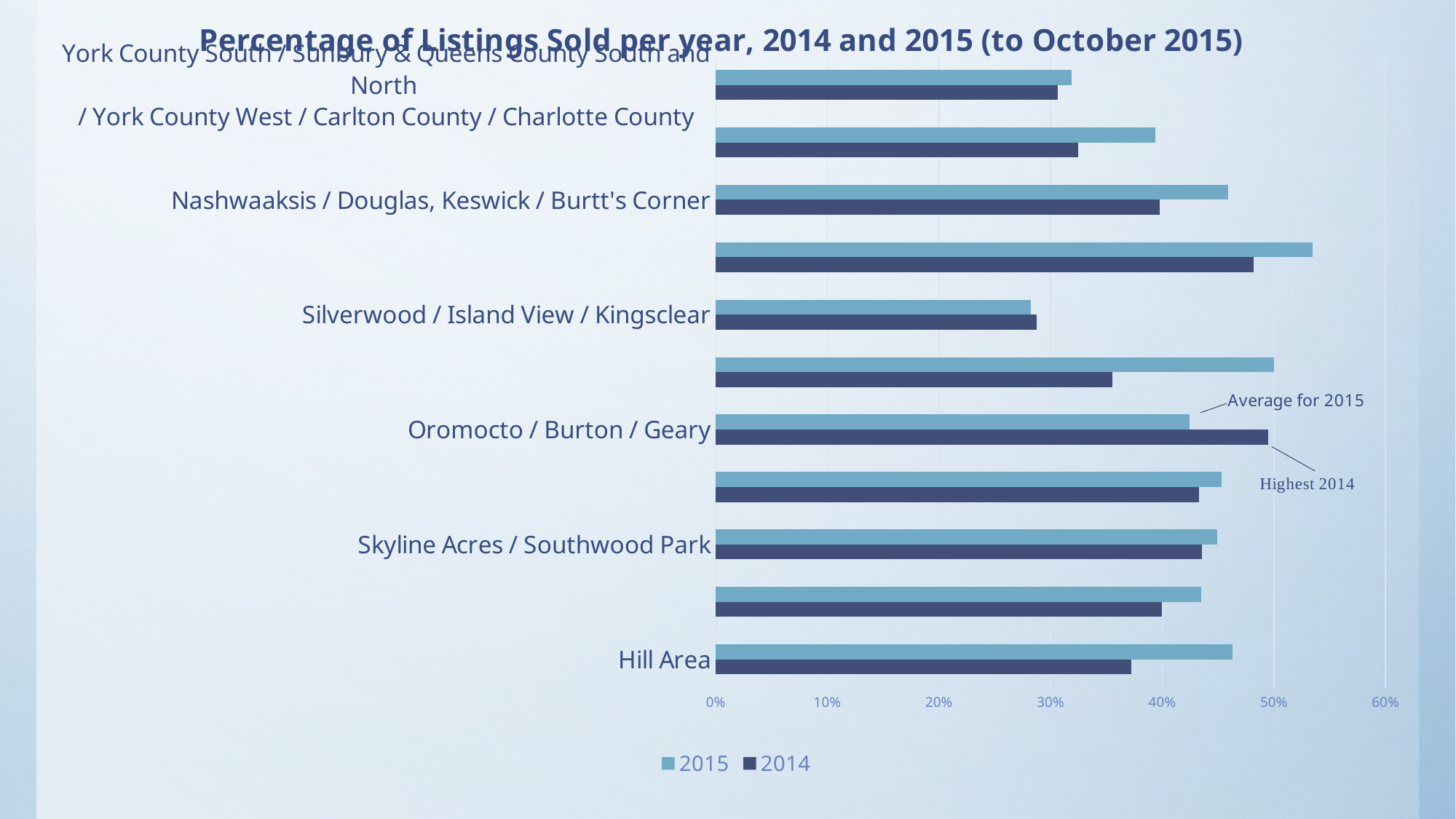
Is the 2015 value for Hill Area greater or less than 40%? greater What kind of chart is shown on the slide? Bar chart How many series does the legend list? 2 Is the 2014 value for Hill Area greater or less than 40%? less How many groups of bars are plotted on the chart? 11 For Oromocto / Burton / Geary, which year has the larger value, 2015 or 2014? 2014 Is the 2014 value for Oromocto / Burton / Geary greater or less than 40%? greater For Hill Area, which year has the larger value, 2015 or 2014? 2015 Which labelled category has the lowest 2015 value? Silverwood / Island View / Kingsclear What are the two series shown in the legend? 2015 and 2014 What is the title of the chart? Percentage of Listings Sold per year, 2014 and 2015 (to October 2015)